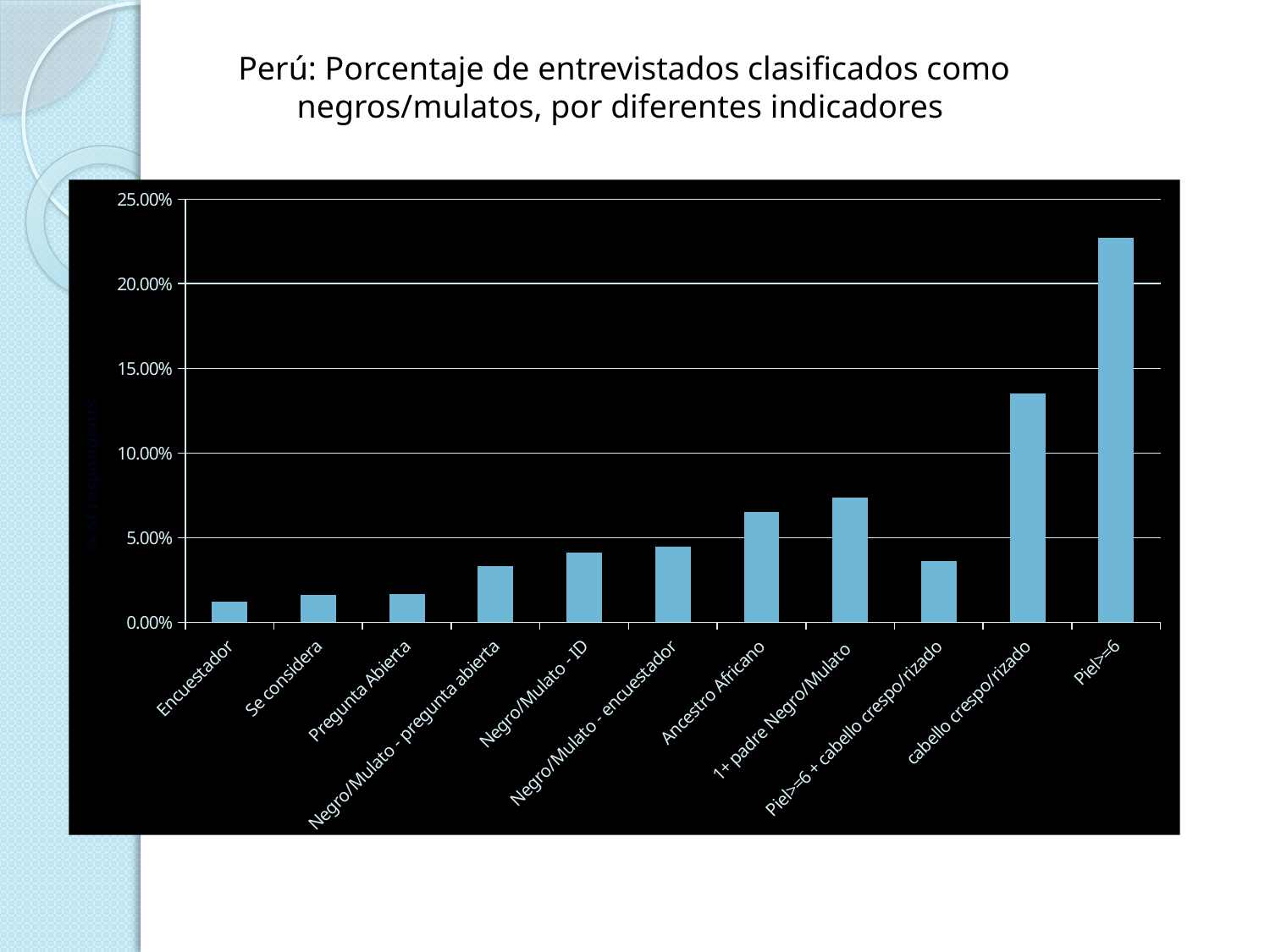
Which indicator has the highest percentage of respondents classified as negros/mulatos? Piel>=6 Is the value for cabello crespo/rizado greater or less than 15.00%? less Is the value for cabello crespo/rizado greater or less than 10.00%? greater What kind of chart is shown on the slide? Bar chart Is the value for Negro/Mulato - ID greater or less than 5.00%? less Which is larger: the value for cabello crespo/rizado or the value for Piel>=6 + cabello crespo/rizado? cabello crespo/rizado Which indicator has the lowest percentage of respondents classified as negros/mulatos? Encuestador What is the title of the chart on the slide? Perú: Porcentaje de entrevistados clasificados como negros/mulatos, por diferentes indicadores How many categories (indicators) are plotted on the x axis? 11 Which is larger: the value for 1+ padre Negro/Mulato or the value for Negro/Mulato - encuestador? 1+ padre Negro/Mulato